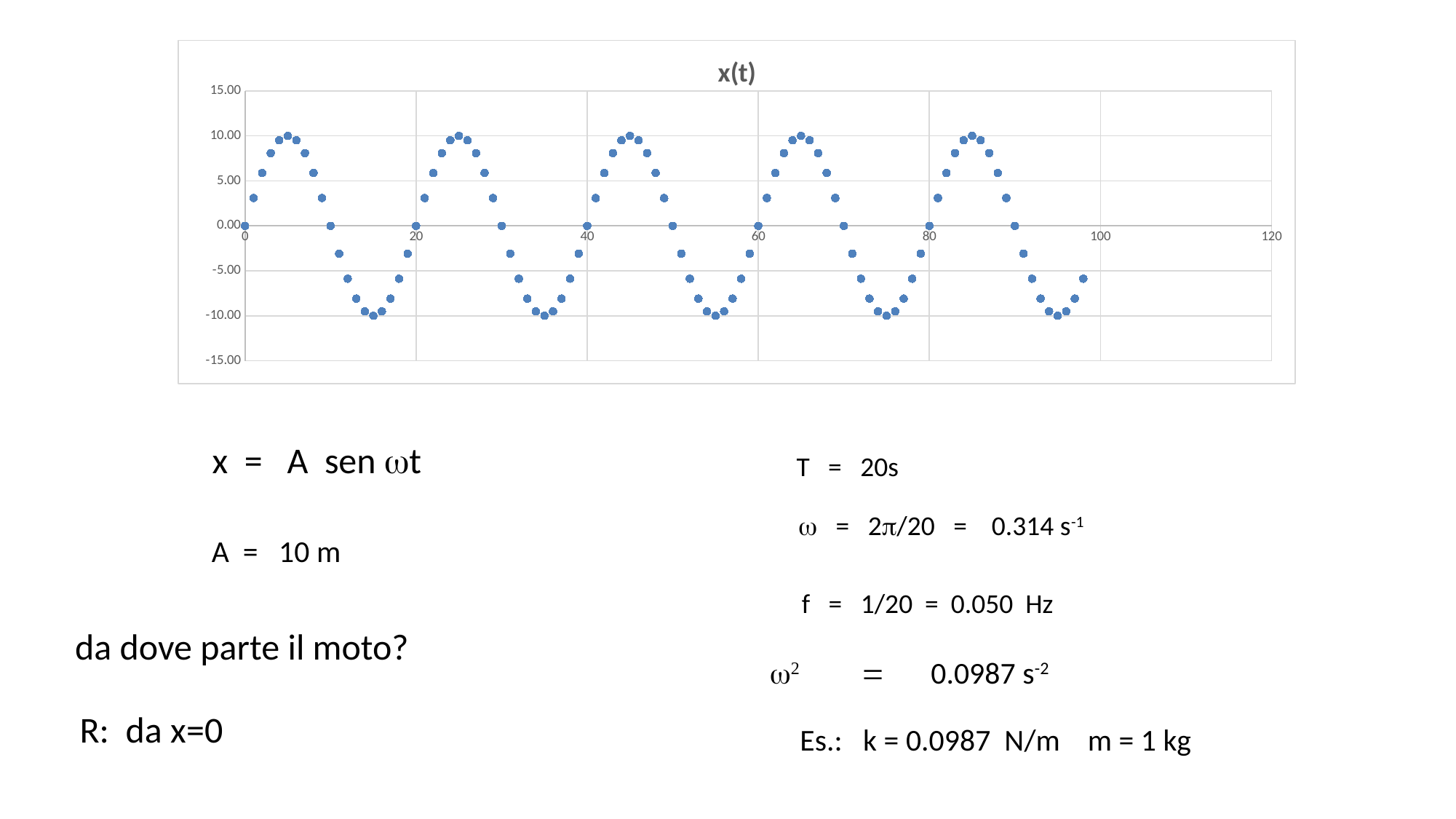
Is the value of x at t = 45 greater or less than 5.00? greater What is the value of x at t = 0 on the chart? 0.00 What is the highest value shown on the vertical axis of the chart? 15.00 Do the plotted values rise steadily, fall steadily, or oscillate along the x axis? oscillate What is the value of x at t = 20 on the chart? 0.00 What is the maximum value reached by the plotted points on the chart? 10.00 What is the minimum value reached by the plotted points on the chart? -10.00 Which is larger on the chart, the value of x at t = 5 or at t = 15? t = 5 What is the title of the chart? x(t) What kind of chart is shown on the slide? scatter chart Is the value of x at t = 13 greater or less than -5.00? less Is the value of x at t = 3 greater or less than 5.00? greater